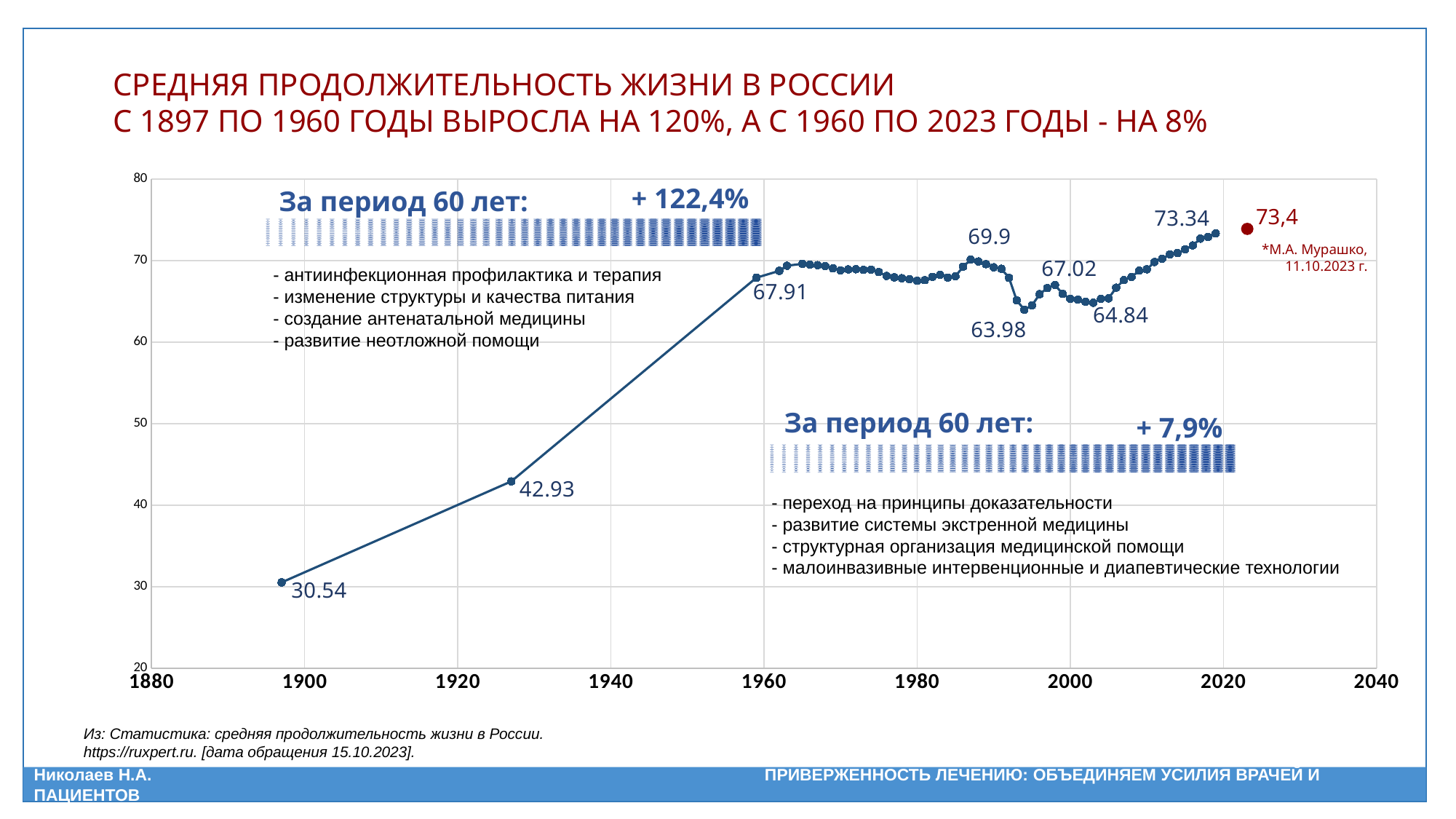
What is the lowest labeled value on the chart? 30.54 What is the lowest labeled value in the period after 1960? 63.98 What is the difference between the labeled value 73.34 (near 2020) and the first labeled value 30.54? 42.80 What is the value of the first (leftmost) data point on the line, labeled near 1897? 30.54 What is the value of the red data point at the right end of the chart, near 2023? 73,4 Does the line rise or fall between 1897 and 1960? rise What kind of chart is shown on the slide? line chart What percentage increase is shown in the annotation for the first 60-year period (upper left of the chart)? + 122,4% What is the difference between the labeled peak 69.9 (late 1980s) and the labeled low 63.98 (mid 1990s)? 5.92 What is the value of the data point labeled just before 1960 on the line? 67.91 Is the value of the line at 1940 greater or less than 60? less What is the value of the labeled data point between 1920 and 1940? 42.93